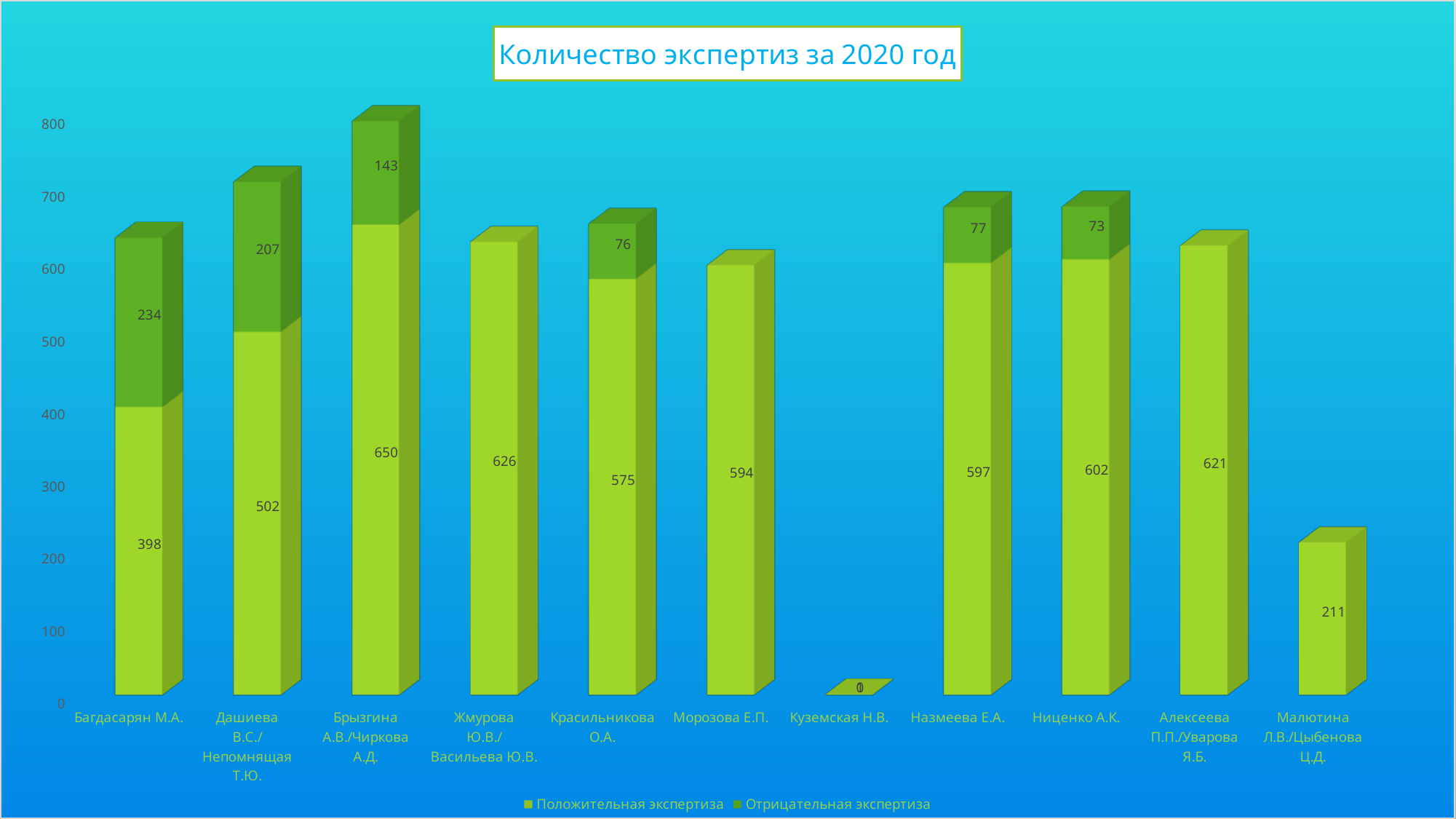
How many categories are shown on the x axis? 11 Which has the larger Положительная экспертиза value: Ниценко А.К. or Назмеева Е.А.? Ниценко А.К. What kind of chart is shown on the slide? Stacked bar chart Which category has the highest value of Отрицательная экспертиза? Багдасарян М.А. Which category has the lowest value of Положительная экспертиза? Куземская Н.В. What is the value of Положительная экспертиза for Брызгина А.В./Чиркова А.Д.? 650 What is the difference between the Отрицательная экспертиза values for Дашиева В.С./Непомнящая Т.Ю. and Брызгина А.В./Чиркова А.Д.? 64 How many series does the legend list? 2 What is the value of Отрицательная экспертиза for Багдасарян М.А.? 234 What is the total of the stacked bar for Брызгина А.В./Чиркова А.Д.? 793 What is the title of the chart? Количество экспертиз за 2020 год Which category has the highest value of Положительная экспертиза? Брызгина А.В./Чиркова А.Д.